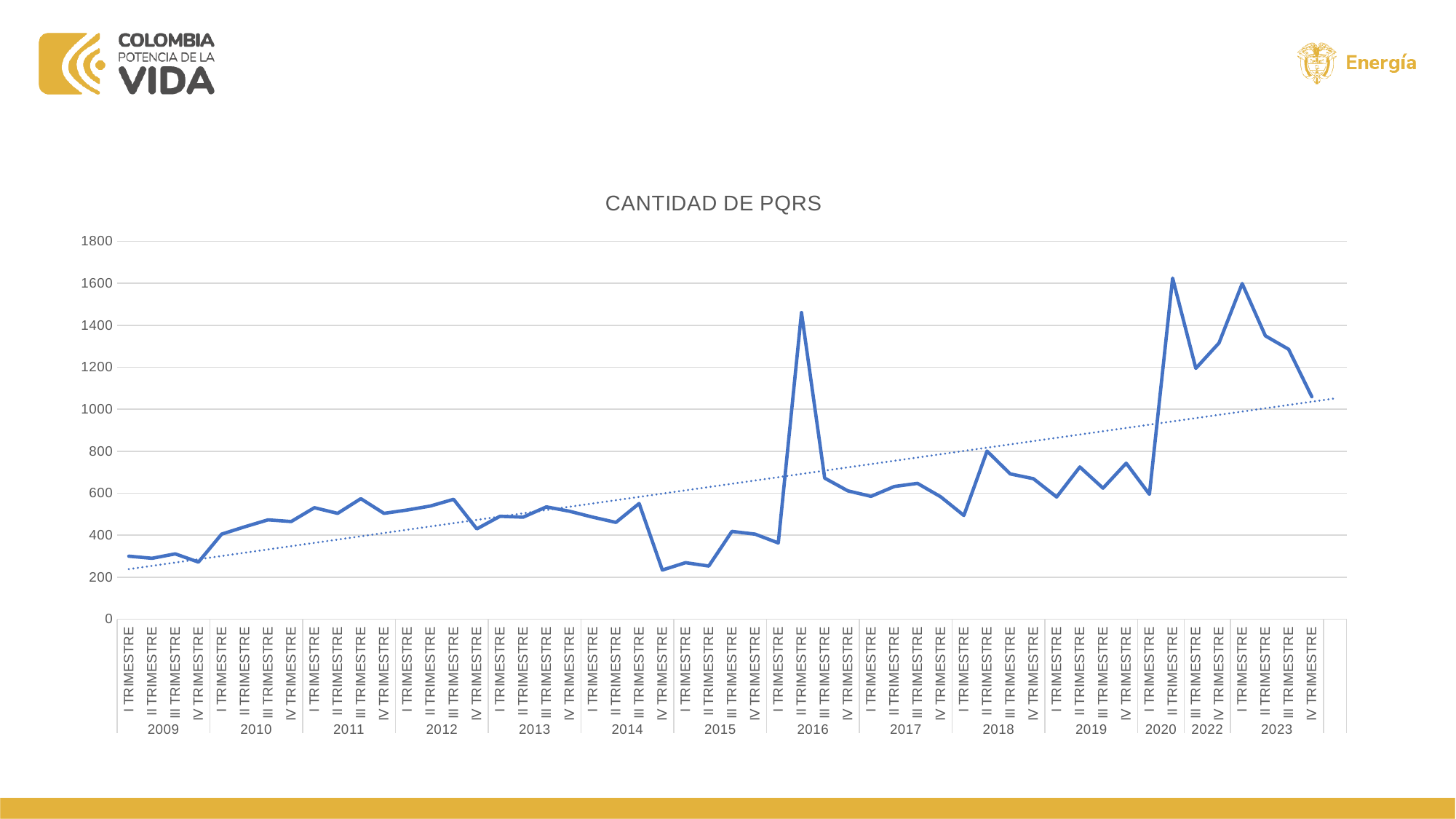
Which is larger, the value for I TRIMESTRE 2023 or the value for I TRIMESTRE 2010? I TRIMESTRE 2023 What kind of chart is shown on the slide? line chart What is the title of the chart? CANTIDAD DE PQRS Overall, do the values rise or fall from 2009 to 2023 along the x axis? rise Is the value for IV TRIMESTRE 2023 greater or less than 1000? greater Is the value for II TRIMESTRE 2020 greater or less than 1400? greater How many quarters (trimestres) are shown for the year 2020? 2 Which is larger, the value for II TRIMESTRE 2016 or the value for II TRIMESTRE 2015? II TRIMESTRE 2016 Is the value for II TRIMESTRE 2016 greater or less than 1400? greater